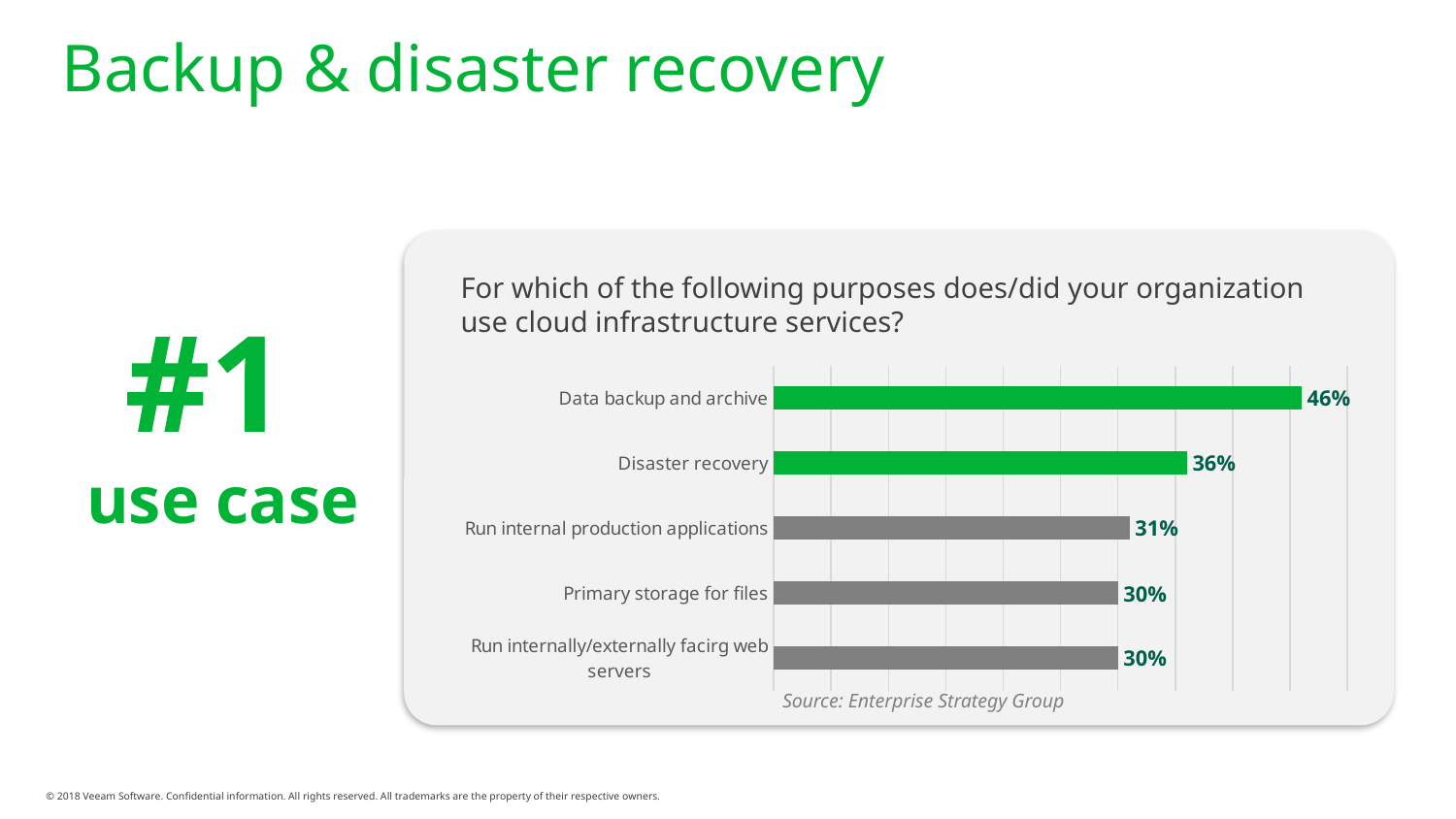
What kind of chart is shown on the slide? Bar chart What is the value for Run internal production applications? 31% What is the value for Data backup and archive? 46% How many categories are shown in the chart? 5 Which category has the highest value? Data backup and archive What is the value for Disaster recovery? 36% Which is larger, the value for Disaster recovery or the value for Primary storage for files? Disaster recovery What is the source cited below the chart? Enterprise Strategy Group What is the value for Primary storage for files? 30% How many bars are coloured green? 2 What is the difference between the values for Data backup and archive and Disaster recovery? 10% What is the difference between the values for Disaster recovery and Run internal production applications? 5%